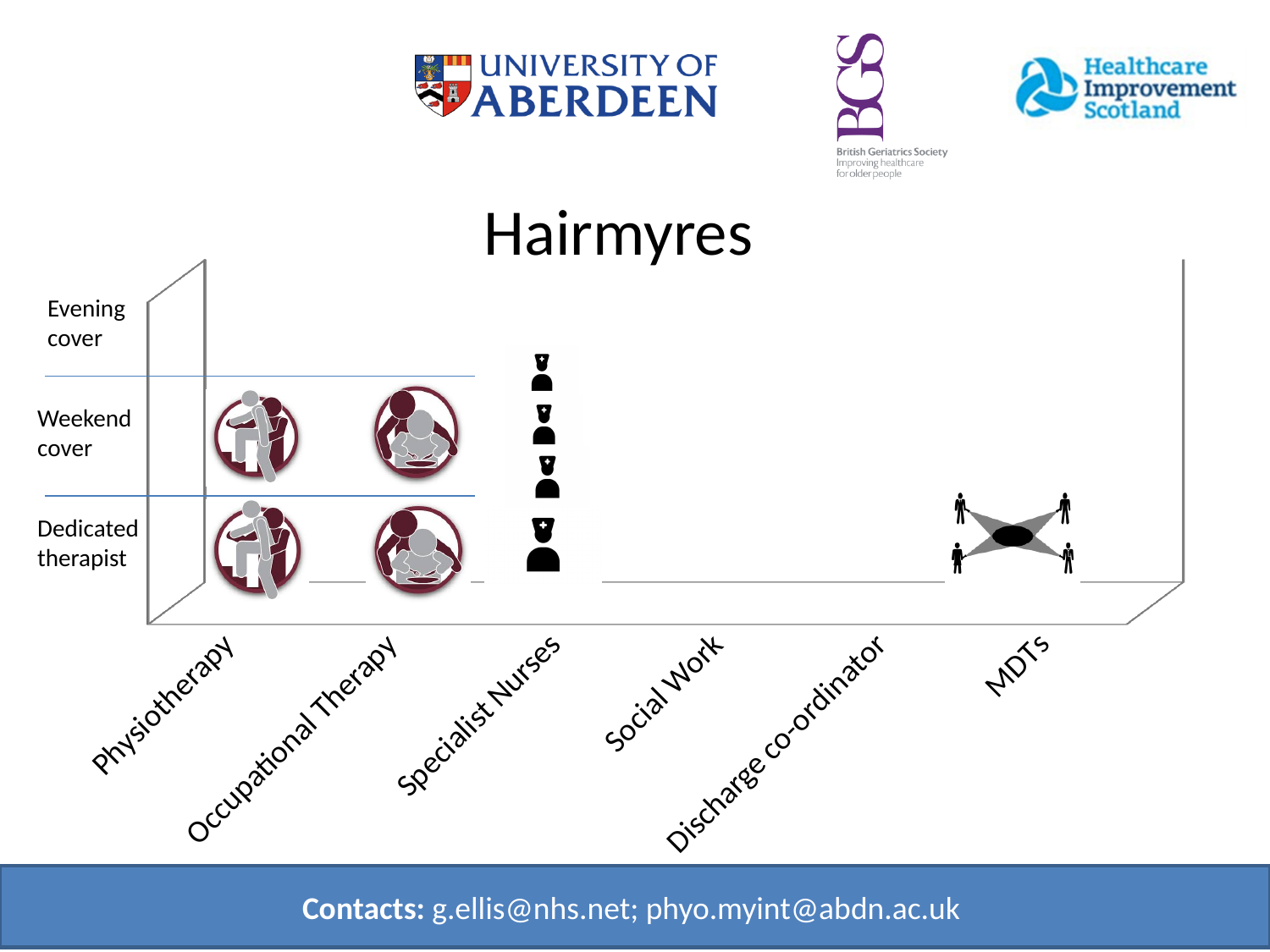
Which category reaches the highest level on the chart? Specialist Nurses What kind of chart is shown on the slide? Bar chart (pictogram with icons) How many categories are shown along the x axis of the chart? 6 How many nurse icons are stacked for Specialist Nurses? 4 Up to which level does the MDTs icon reach? Dedicated therapist What is the title of the chart? Hairmyres Which categories have no icons plotted on the chart? Social Work and Discharge co-ordinator What are the three levels labelled on the vertical axis of the chart? Dedicated therapist, Weekend cover, Evening cover Which category is the only one whose icons reach the Evening cover level? Specialist Nurses Up to which level do the Physiotherapy icons reach? Weekend cover Up to which level do the Occupational Therapy icons reach? Weekend cover Which reaches a higher level on the chart, Specialist Nurses or MDTs? Specialist Nurses